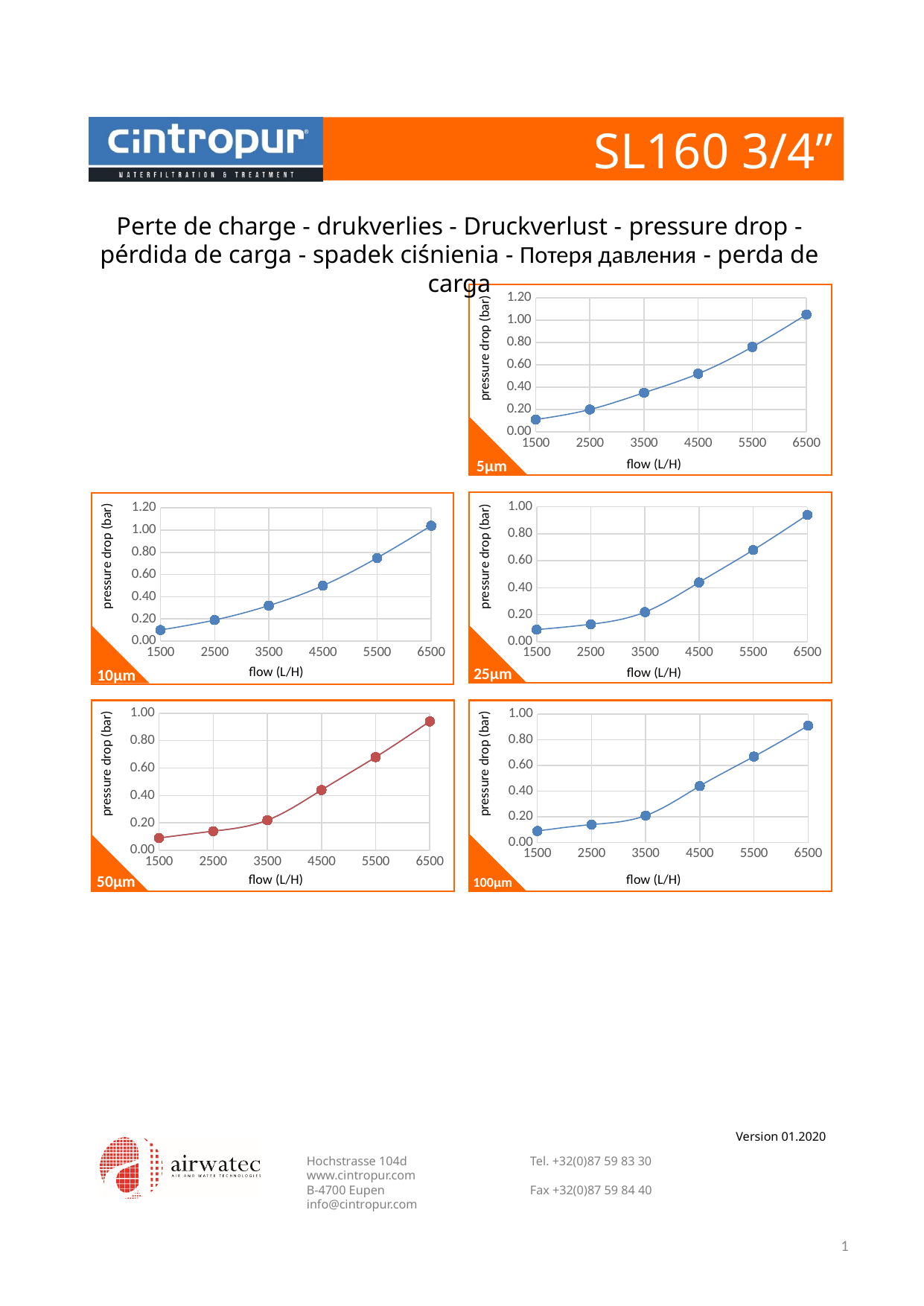
In the 50µm chart, is the pressure drop at a flow of 5500 L/H greater or less than 0.60 bar? greater In the 10µm chart, is the pressure drop at a flow of 5500 L/H greater or less than 0.80 bar? less What kind of chart is the 5µm chart? line chart In the 5µm chart, is the pressure drop at a flow of 6500 L/H greater or less than 1.00 bar? greater How many data points are plotted in the 10µm chart? 6 What colour is the line in the 50µm chart? red In the 10µm chart, does the pressure drop rise or fall as flow increases? rise In the 25µm chart, at which flow value is the pressure drop highest? 6500 In the 50µm chart, which flow value has the lowest pressure drop? 1500 In the 100µm chart, which has the larger pressure drop: a flow of 4500 L/H or 5500 L/H? 5500